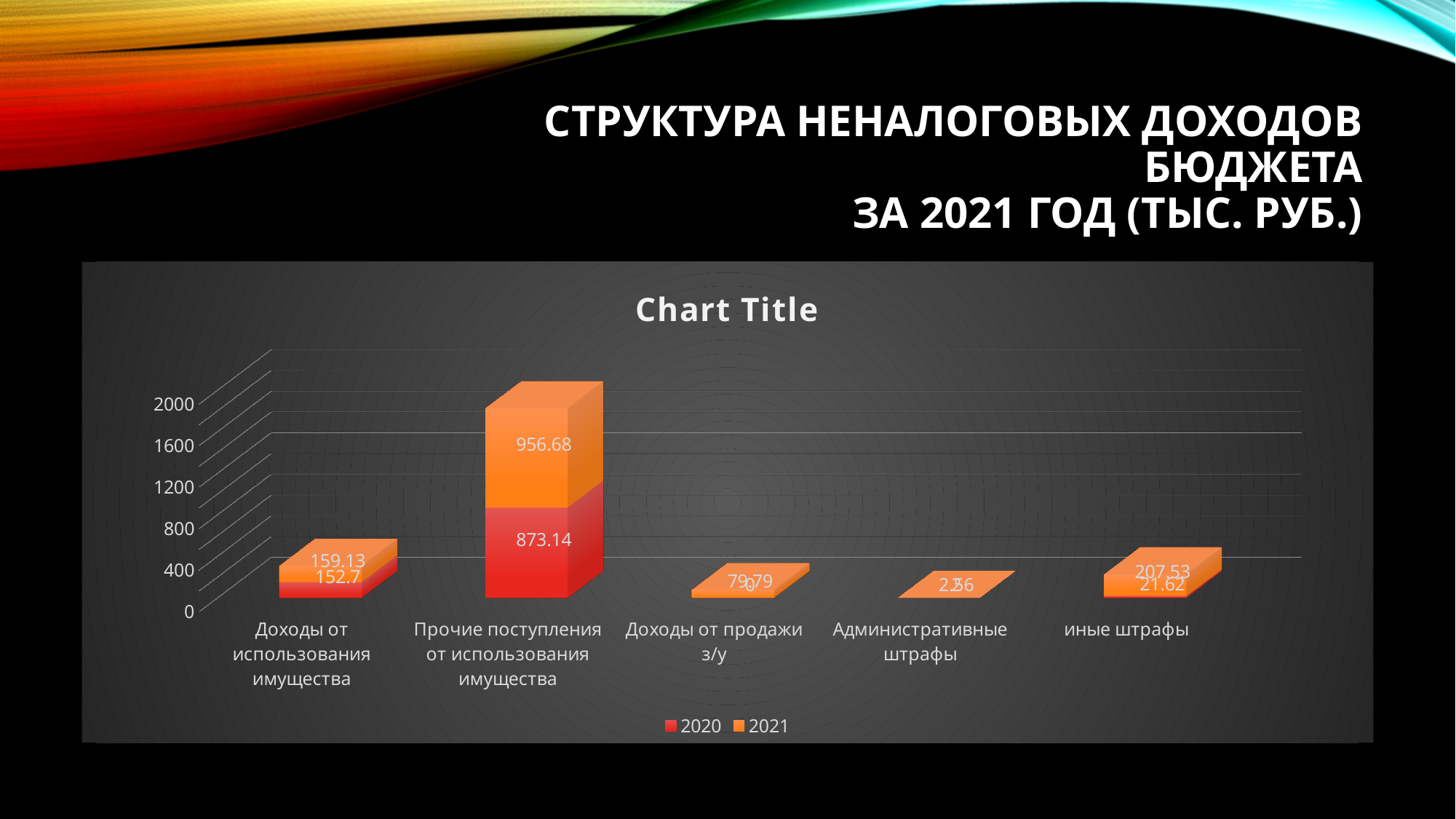
What is the difference between the 2021 and 2020 values for Прочие поступления от использования имущества? 83.54 Which is larger for иные штрафы, the 2020 value or the 2021 value? 2021 What is the total of the stacked bar for Прочие поступления от использования имущества? 1829.82 What is the 2021 value for Прочие поступления от использования имущества? 956.68 How many categories are shown on the x axis? 5 What kind of chart is shown on the slide? Stacked bar chart What is the 2021 value for Доходы от использования имущества? 159.13 What is the 2021 value for иные штрафы? 207.53 What is the 2020 value for иные штрафы? 21.62 What is the 2020 value for Прочие поступления от использования имущества? 873.14 How many series does the legend list? 2 Which category has the highest total stacked value? Прочие поступления от использования имущества